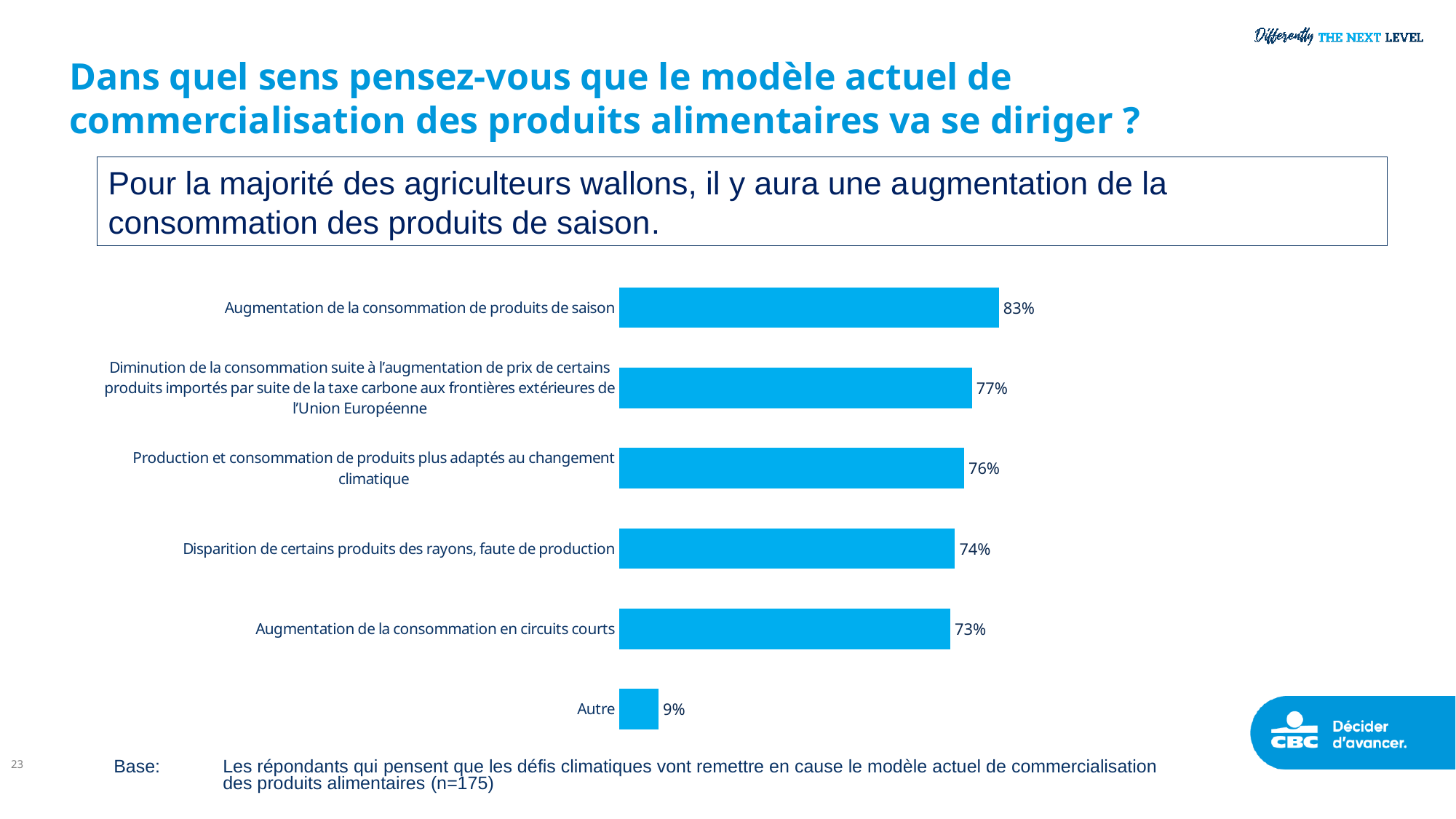
What is the value for "Autre"? 9% How many categories are shown in the chart? 6 What is the value for "Production et consommation de produits plus adaptés au changement climatique"? 76% Which is larger: the value for "Augmentation de la consommation de produits de saison" or the value for "Disparition de certains produits des rayons, faute de production"? Augmentation de la consommation de produits de saison What is the value for "Disparition de certains produits des rayons, faute de production"? 74% What kind of chart is shown on the slide? Bar chart What is the difference between the value for "Augmentation de la consommation de produits de saison" and the value for "Autre"? 74% What is the value for "Augmentation de la consommation en circuits courts"? 73% What is the difference between the value for "Diminution de la consommation suite à l'augmentation de prix de certains produits importés..." and the value for "Augmentation de la consommation en circuits courts"? 4% Which category has the lowest value? Autre Which category has the highest value? Augmentation de la consommation de produits de saison What is the value for "Augmentation de la consommation de produits de saison"? 83%